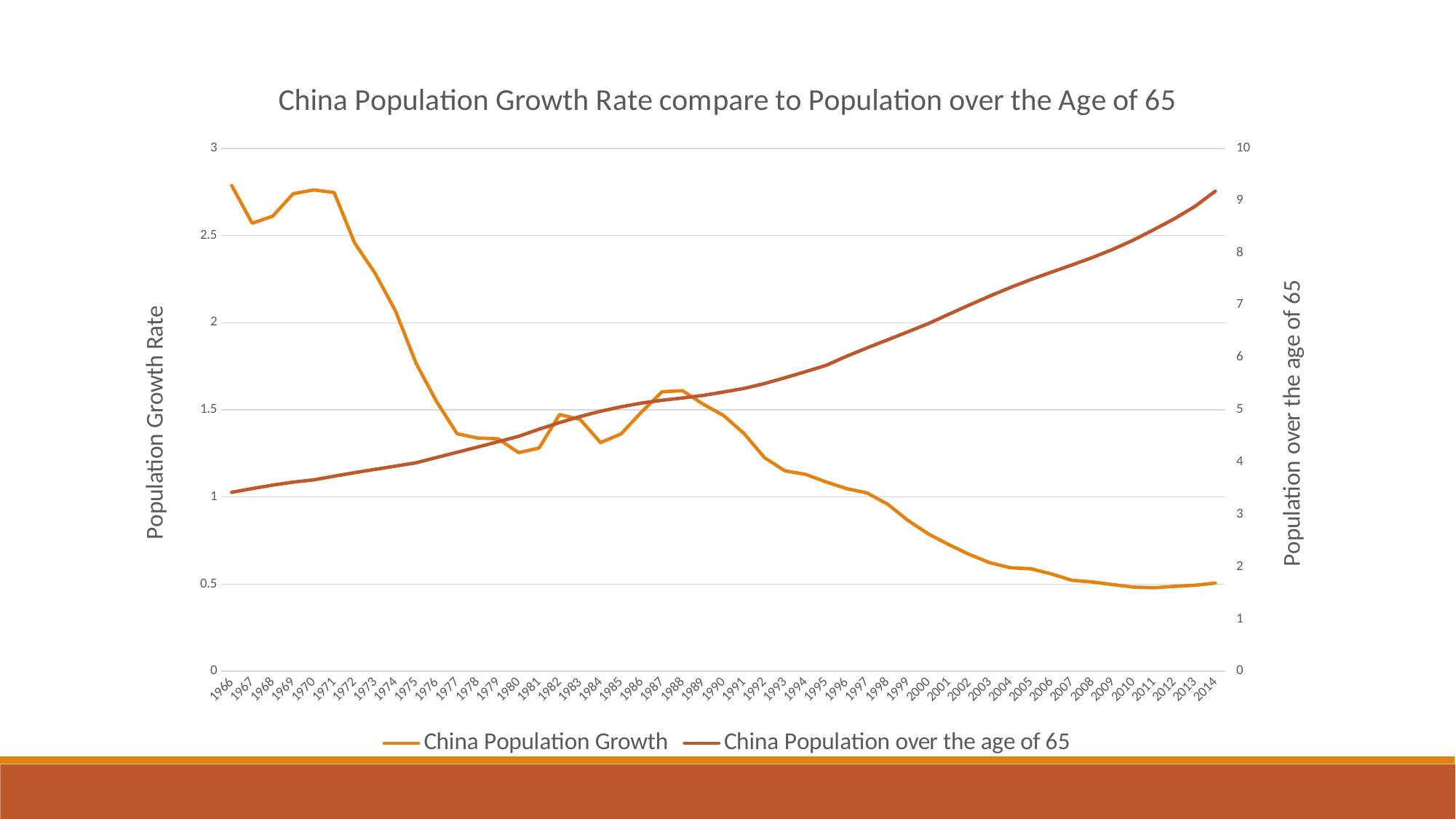
In which year is the China Population over the age of 65 series lowest? 1966 In which year is the China Population over the age of 65 series highest? 2014 Is the China Population over the age of 65 value for 2014 greater or less than 9? greater What is the title of the chart? China Population Growth Rate compare to Population over the Age of 65 Does the China Population over the age of 65 series rise or fall from 1966 to 2014? rise Does the China Population Growth series rise or fall from 1990 to 2014? fall How many series does the legend list? 2 Is the China Population Growth value for 2014 greater or less than 1? less What kind of chart is shown on the slide? line chart How many years are plotted along the x axis? 49 Is the China Population Growth value for 1966 greater or less than 2.5? greater What is the label of the right-hand vertical axis? Population over the age of 65